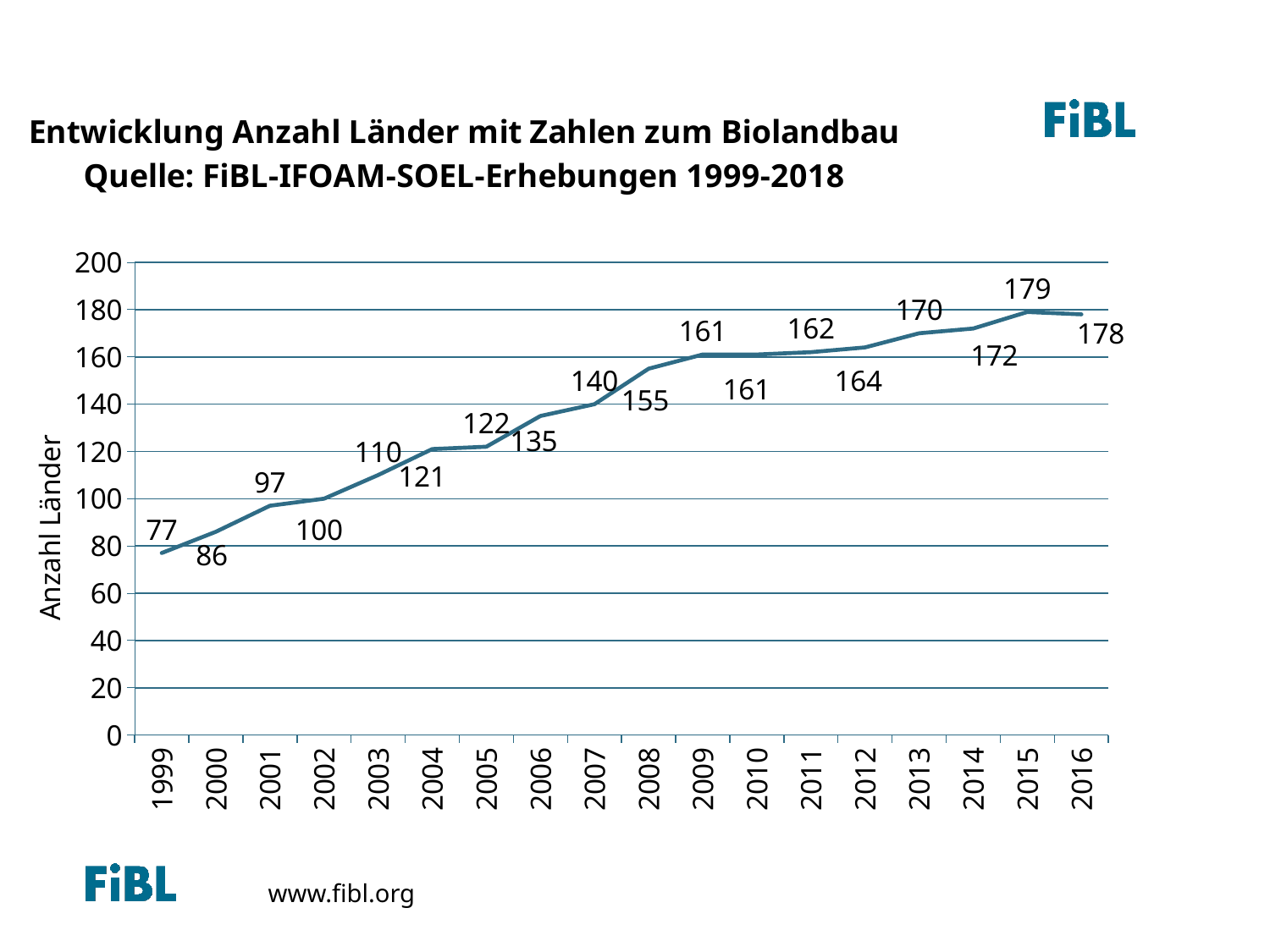
What is the difference between the values for 2015 and 1999? 102 Which year has the lowest value? 1999 What is the label of the y axis? Anzahl Länder Which is larger, the value for 2015 or the value for 2016? 2015 Do the values generally rise or fall from 1999 to 2015? rise What kind of chart is shown on the slide? line chart What is the value for 1999? 77 What is the value for 2008? 155 What is the difference between the values for 2004 and 2003? 11 What is the value for 2016? 178 Which year has the highest value? 2015 How many years are plotted on the x axis? 18